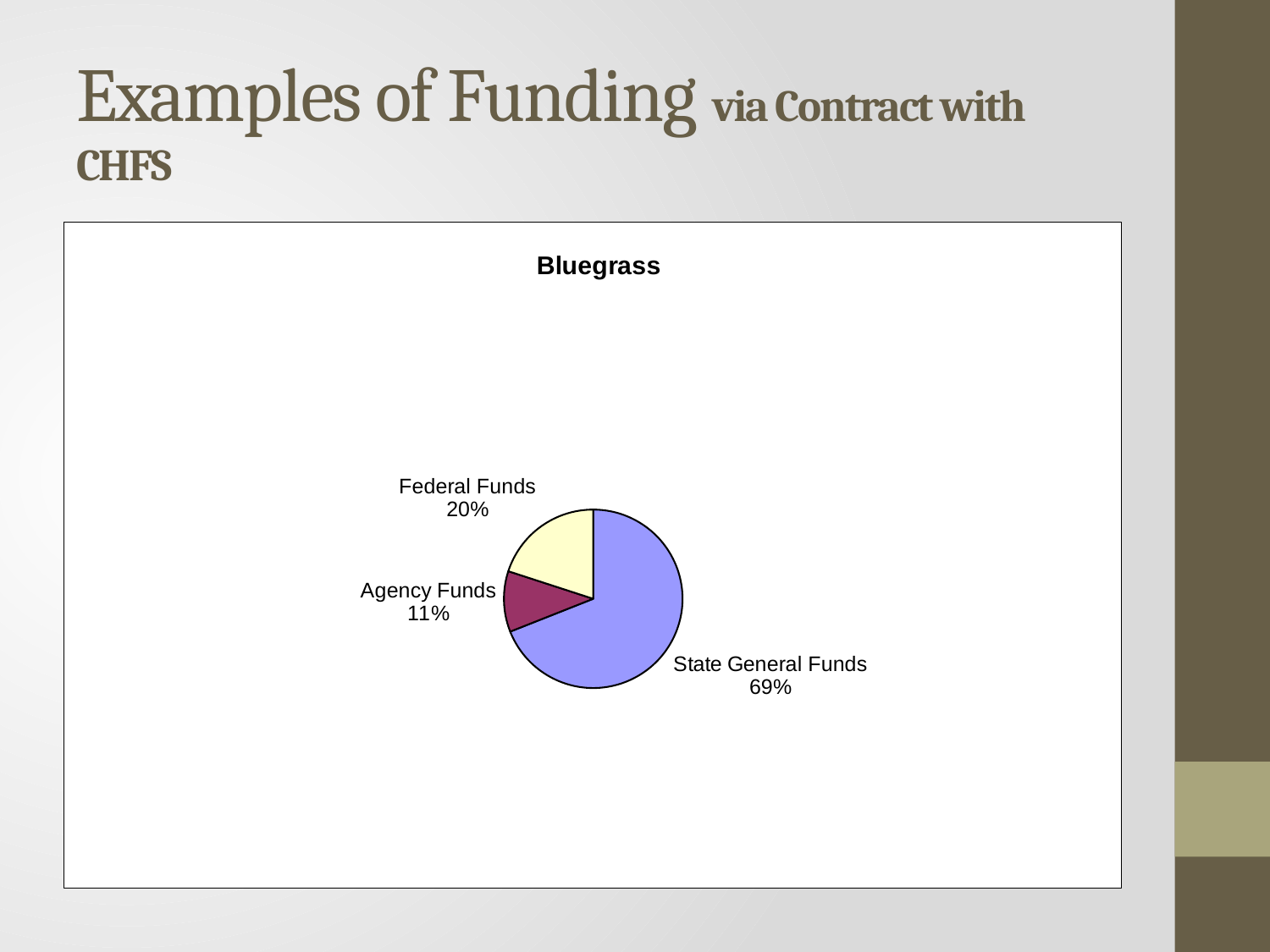
How many slices does the Bluegrass pie chart have? 3 Which slice of the Bluegrass pie chart is the largest? State General Funds What is the difference in percentage points between State General Funds and Federal Funds in the Bluegrass chart? 49 Which is larger in the Bluegrass chart, Federal Funds or Agency Funds? Federal Funds What is the title of the chart on the slide? Bluegrass What colour is the State General Funds slice in the Bluegrass pie chart? Blue What share of the Bluegrass pie chart is State General Funds? 69% What kind of chart is shown on the slide? Pie chart What share of the Bluegrass pie chart is Federal Funds? 20% What is the difference in percentage points between Federal Funds and Agency Funds in the Bluegrass chart? 9 What share of the Bluegrass pie chart is Agency Funds? 11% Which slice of the Bluegrass pie chart is the smallest? Agency Funds